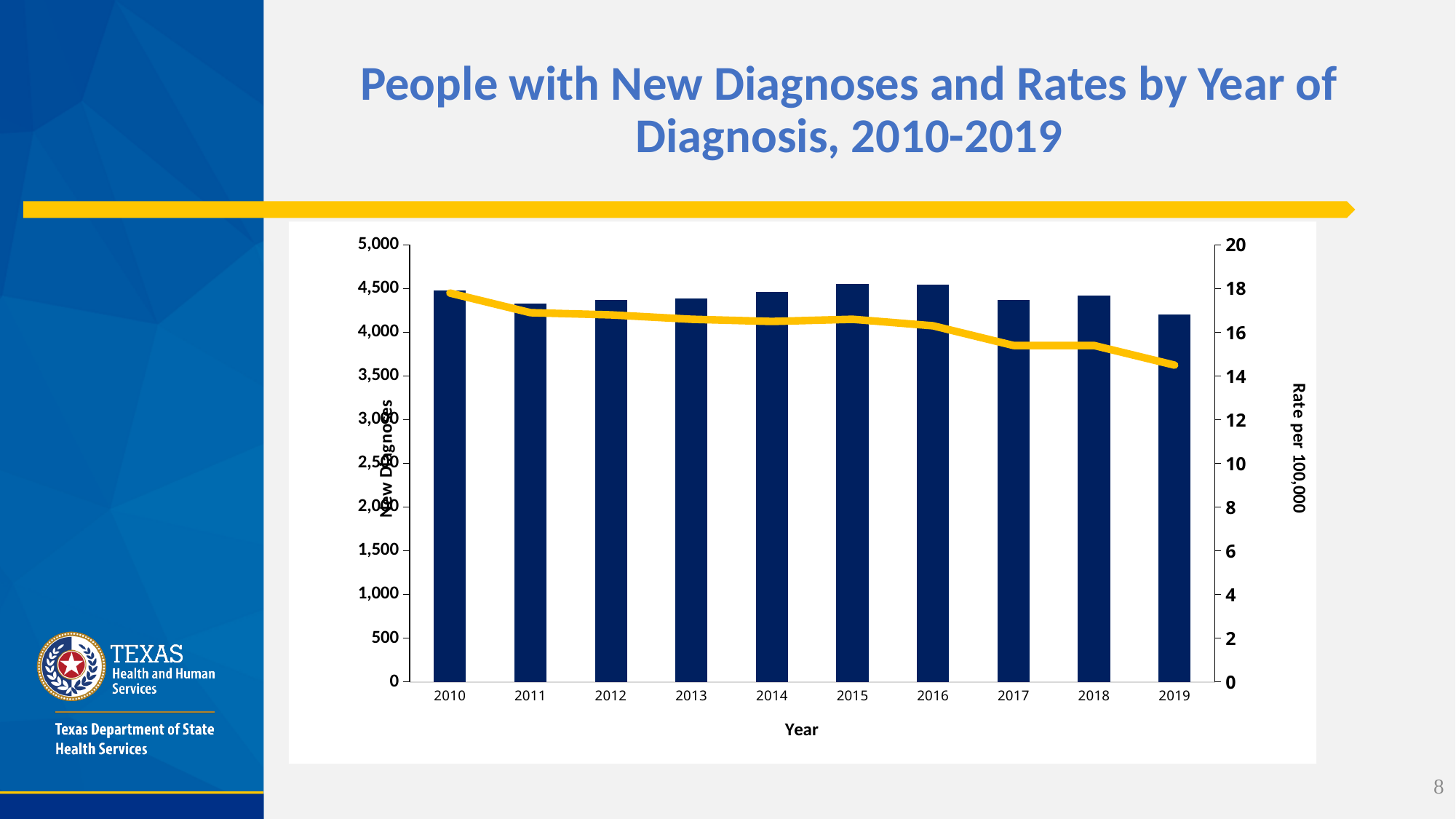
Which year has the lowest rate per 100,000 on the line? 2019 Which year has the highest rate per 100,000 on the line? 2010 Is the number of new diagnoses in 2019 greater or less than 4,000? greater Which year has the lowest bar for new diagnoses? 2019 Which year has more new diagnoses, 2010 or 2019? 2010 Does the rate per 100,000 line generally rise or fall from 2010 to 2019? Fall Is the rate per 100,000 in 2019 greater or less than 16? less What is the title of the right-hand vertical axis? Rate per 100,000 Is the number of new diagnoses in 2019 greater or less than 4,500? less What kind of chart is shown on the slide? A bar chart combined with a line chart How many years are shown on the x axis of the chart? 10